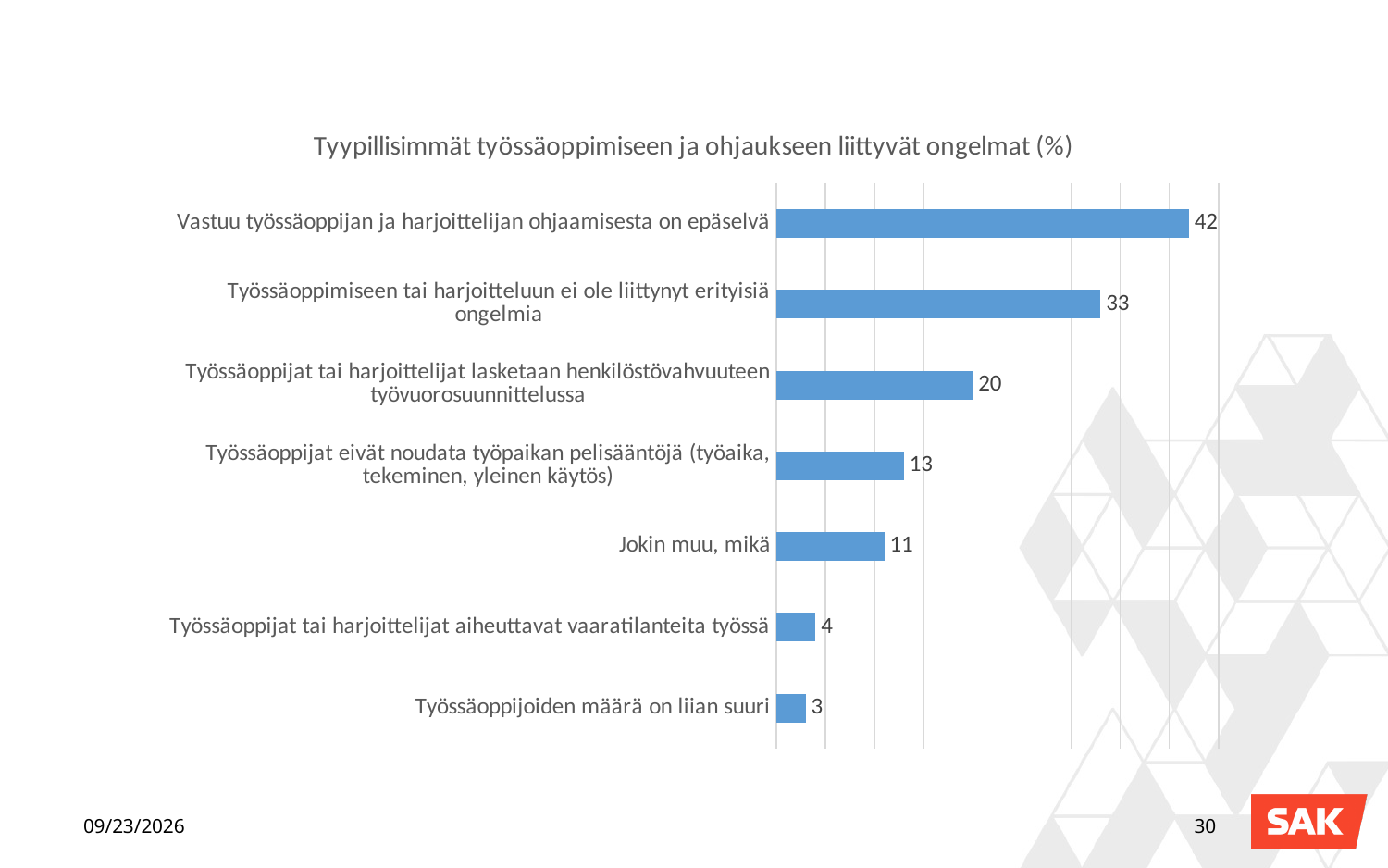
What is the value for "Työssäoppijat tai harjoittelijat lasketaan henkilöstövahvuuteen työvuorosuunnittelussa"? 20 Which is larger: the value for "Työssäoppijat tai harjoittelijat aiheuttavat vaaratilanteita työssä" or for "Työssäoppijoiden määrä on liian suuri"? Työssäoppijat tai harjoittelijat aiheuttavat vaaratilanteita työssä What is the title of the chart? Tyypillisimmät työssäoppimiseen ja ohjaukseen liittyvät ongelmat (%) What kind of chart is shown on the slide? Bar chart Which category has the lowest value? Työssäoppijoiden määrä on liian suuri What is the value for "Vastuu työssäoppijan ja harjoittelijan ohjaamisesta on epäselvä"? 42 What colour are the bars in the chart? Blue What is the difference between the values for "Vastuu työssäoppijan ja harjoittelijan ohjaamisesta on epäselvä" and "Työssäoppimiseen tai harjoitteluun ei ole liittynyt erityisiä ongelmia"? 9 What is the difference between the values for "Työssäoppijat eivät noudata työpaikan pelisääntöjä (työaika, tekeminen, yleinen käytös)" and "Jokin muu, mikä"? 2 How many categories are shown in the chart? 7 What is the value for "Jokin muu, mikä"? 11 Which category has the highest value? Vastuu työssäoppijan ja harjoittelijan ohjaamisesta on epäselvä